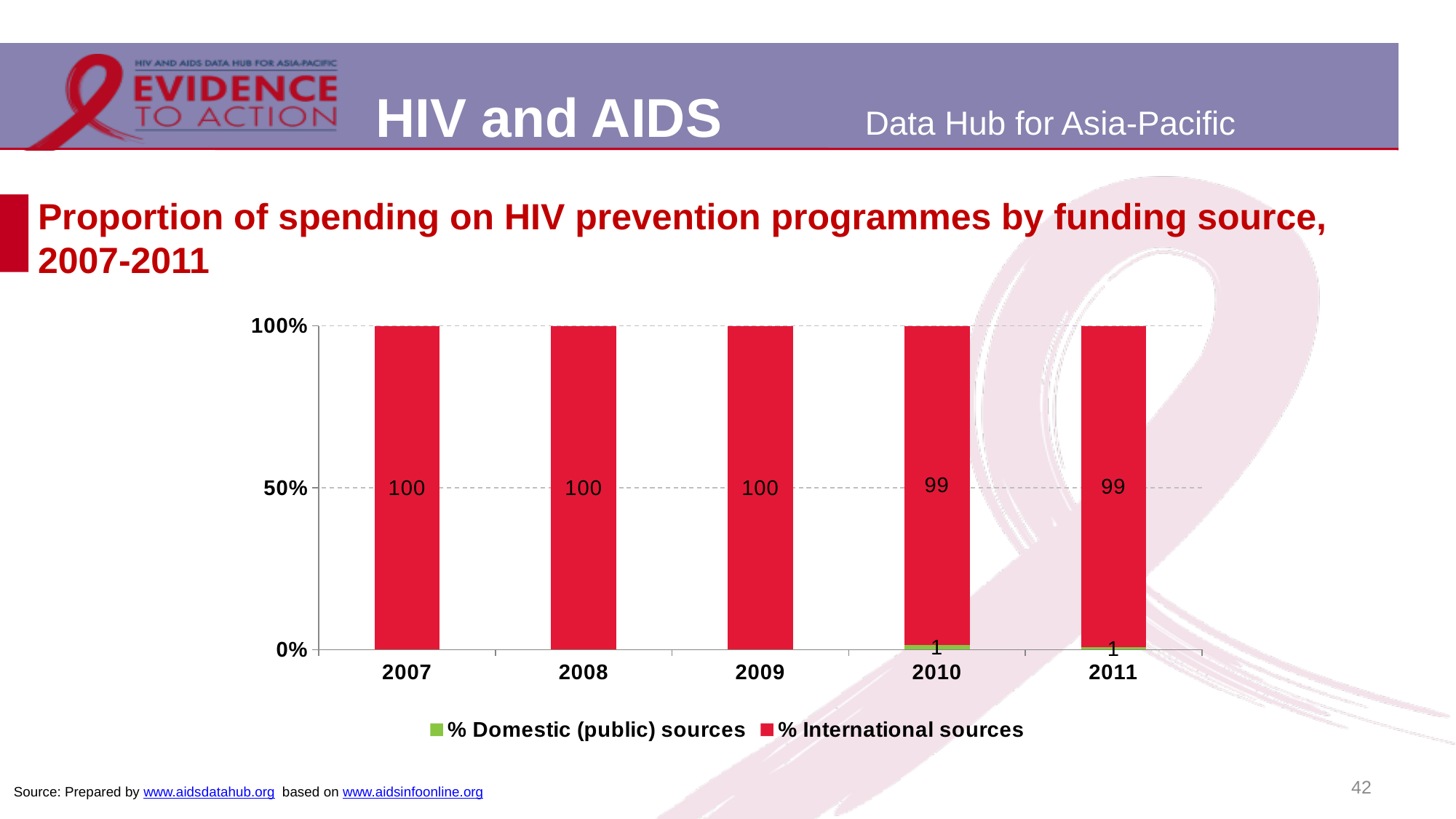
What is the value for % Domestic (public) sources in 2011? 1 Does the value for % International sources rise or fall from 2007 to 2011? fall What is the total of the stacked bar for 2010? 100 What is the value for % International sources in 2009? 100 How many series does the legend list? 2 What is the value for % International sources in 2010? 99 What kind of chart is shown on the slide? stacked bar chart How many years are shown on the x axis? 5 Which colour represents % Domestic (public) sources in the legend? green What is the difference between % International sources in 2008 and in 2011? 1 What is the value for % International sources in 2007? 100 Which is larger in 2010, % International sources or % Domestic (public) sources? % International sources